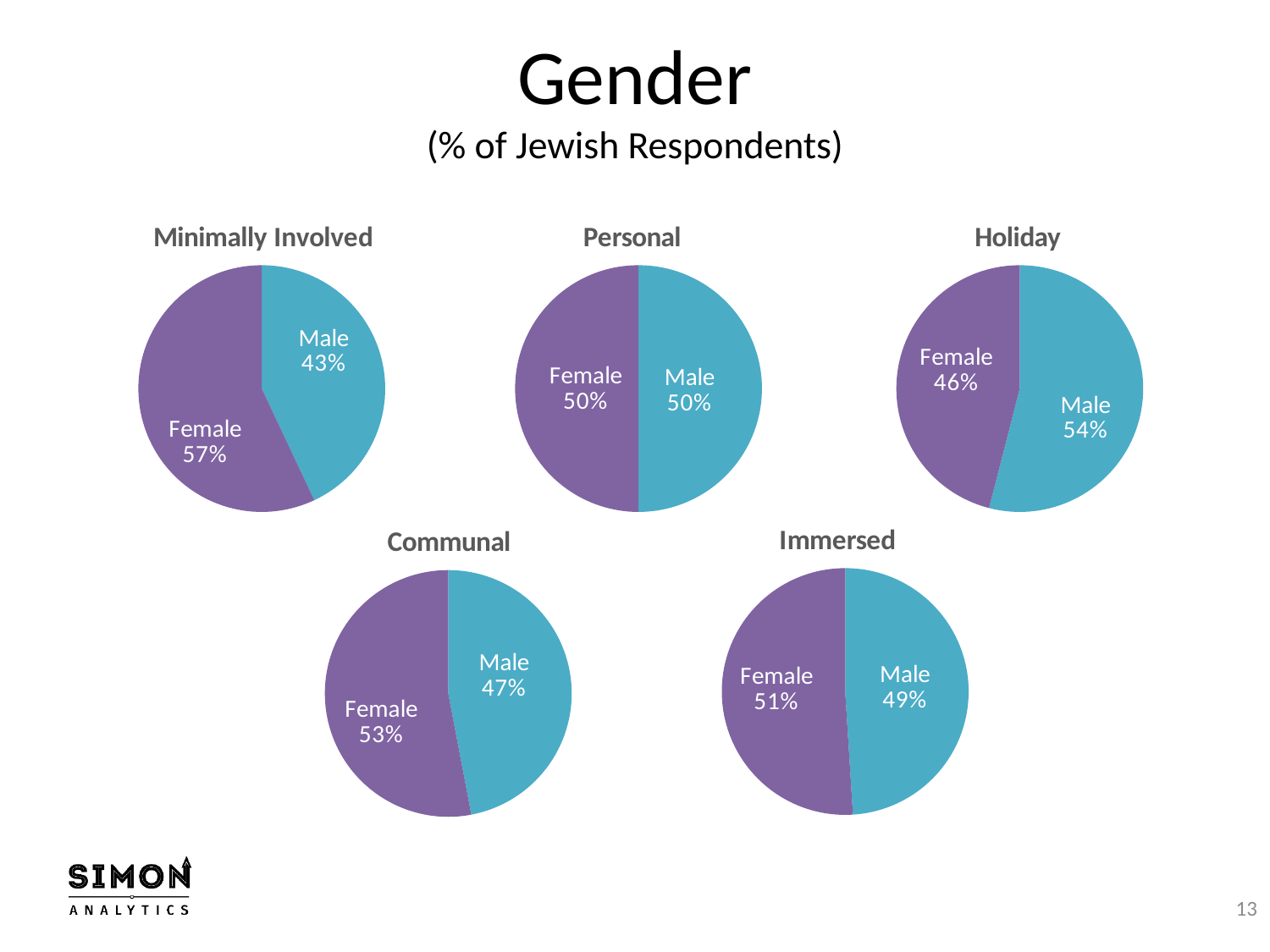
In the Minimally Involved chart, what is the difference between the Female and Male percentages? 14% How many pie charts are shown on the slide? 5 How many slices does the Communal chart have? 2 In the Communal chart, what percentage of respondents are Male? 47% In the Holiday chart, which slice is larger, Male or Female? Male In the Personal chart, what percentage of respondents are Female? 50% In the Minimally Involved chart, what percentage of respondents are Female? 57% What kind of chart is used on this slide? Pie chart In the Holiday chart, what is the difference between the Male and Female percentages? 8% In the Holiday chart, what percentage of respondents are Male? 54% In the Immersed chart, what percentage of respondents are Female? 51% In the Minimally Involved chart, which slice is larger, Male or Female? Female